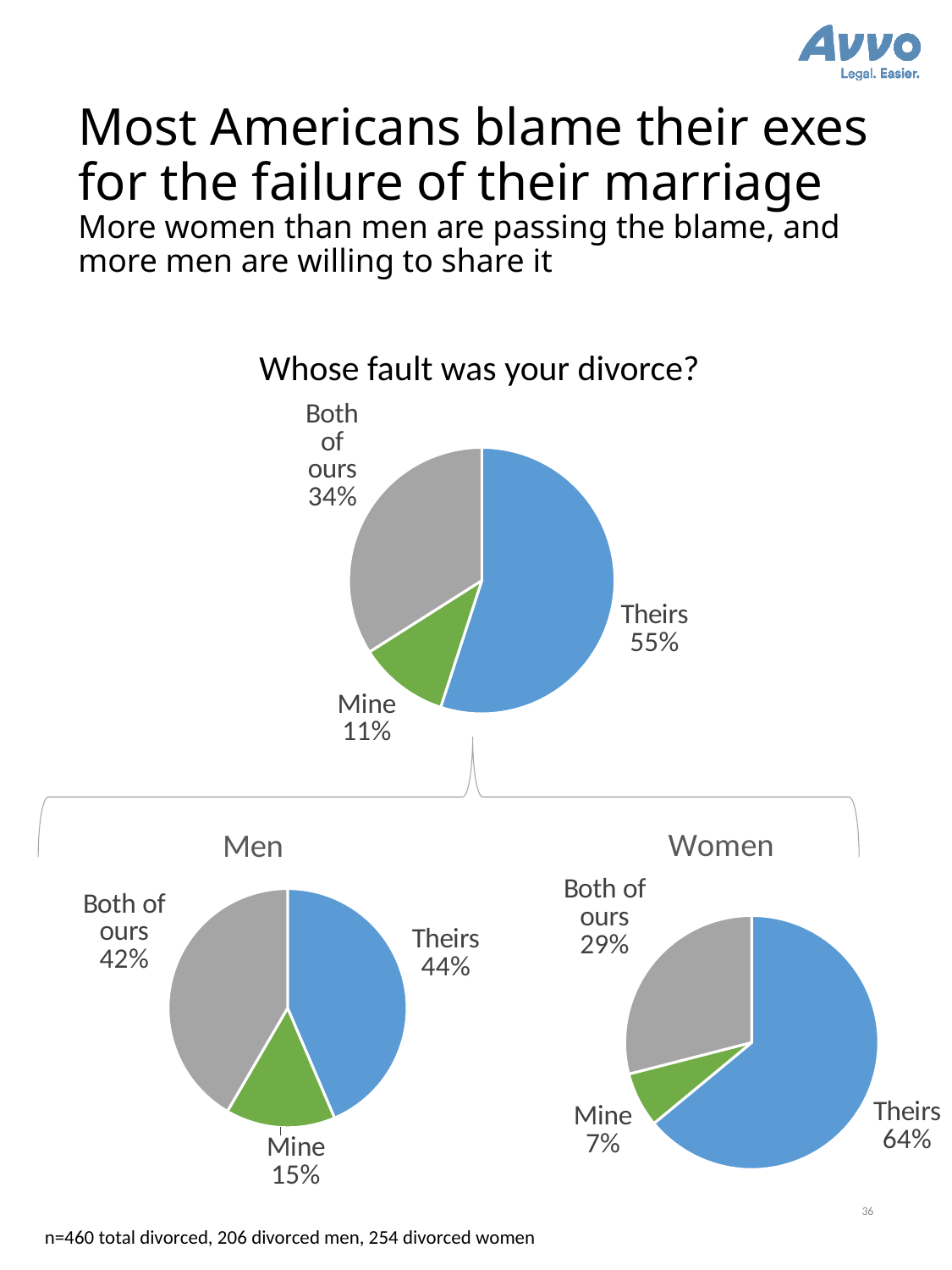
In the Women pie chart, which answer has the smallest share? Mine In the 'Whose fault was your divorce?' pie chart, what percentage answered 'Mine'? 11% In the 'Whose fault was your divorce?' pie chart, what percentage answered 'Theirs'? 55% In the 'Whose fault was your divorce?' pie chart, which answer has the smallest share? Mine In the 'Whose fault was your divorce?' pie chart, which answer has the largest share? Theirs In the Men pie chart, what is the difference between 'Theirs' and 'Mine'? 29% In the Women pie chart, what percentage answered 'Theirs'? 64% What type of chart is used for the Women chart? Pie chart In the Men pie chart, what percentage answered 'Both of ours'? 42% What is the title of the top chart on the slide? Whose fault was your divorce? How many slices does the Men pie chart have? 3 Which is larger: the 'Theirs' share in the Men pie chart or the 'Theirs' share in the Women pie chart? Women